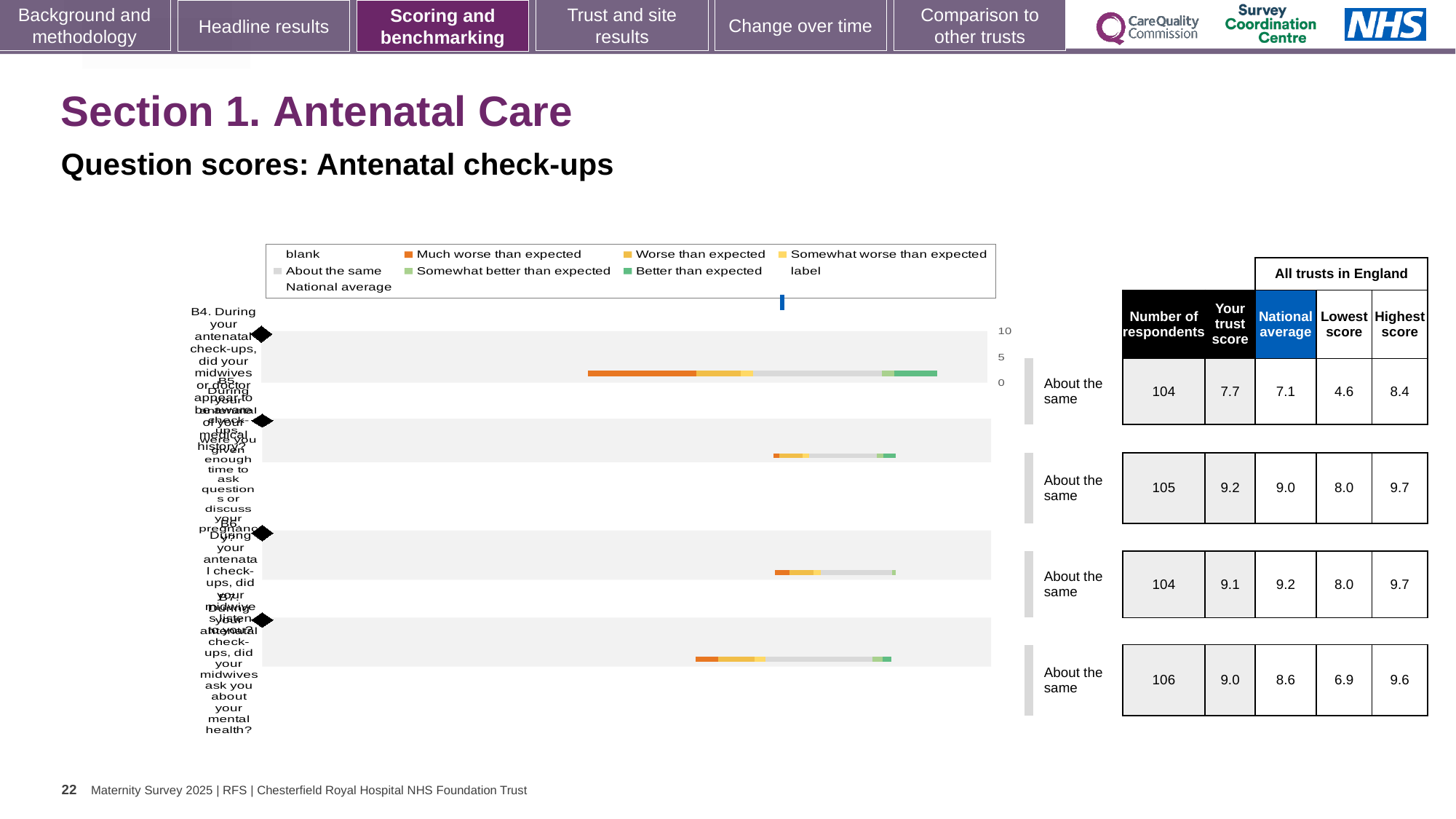
What kind of chart is shown on the slide? bar chart In the table beside the chart, which row has the lowest 'Lowest score' value? the first row (B4), 4.6 In the table beside the chart, is the trust score for the second row (B5) or the third row (B6) larger? the second row (B5), 9.2 In the table beside the chart, what is the difference between the trust score and the national average for the first row (B4)? 0.6 What benchmark label is shown next to each of the four bars? About the same What is the subtitle above the chart? Question scores: Antenatal check-ups In the table beside the chart, what is the trust score for the second row (B5)? 9.2 In the table beside the chart, which row has the highest number of respondents? the fourth row (B7), 106 In the table beside the chart, what is the number of respondents for the first row (B4)? 104 How many question bars are plotted in the chart? 4 What colour does the legend use for 'Much worse than expected'? orange In the table beside the chart, what is the national average for the fourth row (B7)? 8.6